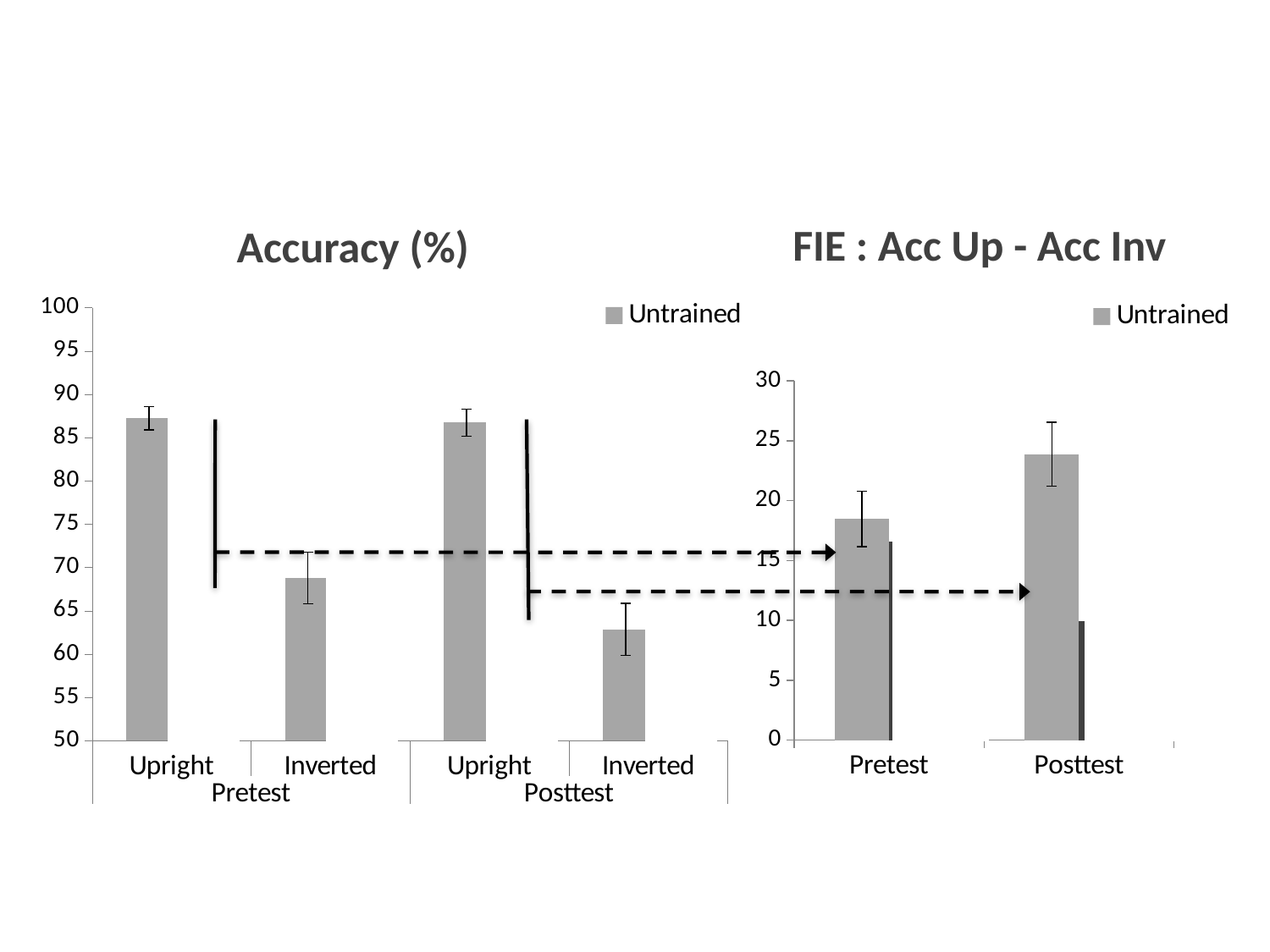
In the Accuracy (%) chart, which is larger, Pretest Inverted or Posttest Inverted? Pretest Inverted In the Accuracy (%) chart, is the value for Posttest Inverted greater or less than 65? less In the Accuracy (%) chart, which bar is the lowest? Posttest Inverted In the FIE : Acc Up - Acc Inv chart, is the value for Posttest greater or less than 20? greater What kind of chart is the Accuracy (%) chart? bar chart In the Accuracy (%) chart, which is larger, Posttest Upright or Posttest Inverted? Posttest Upright How many series does the legend of the FIE : Acc Up - Acc Inv chart list? 1 How many bars are plotted in the Accuracy (%) chart? 4 In the FIE : Acc Up - Acc Inv chart, is the value for Pretest greater or less than 15? greater In the FIE : Acc Up - Acc Inv chart, which category has the higher value? Posttest